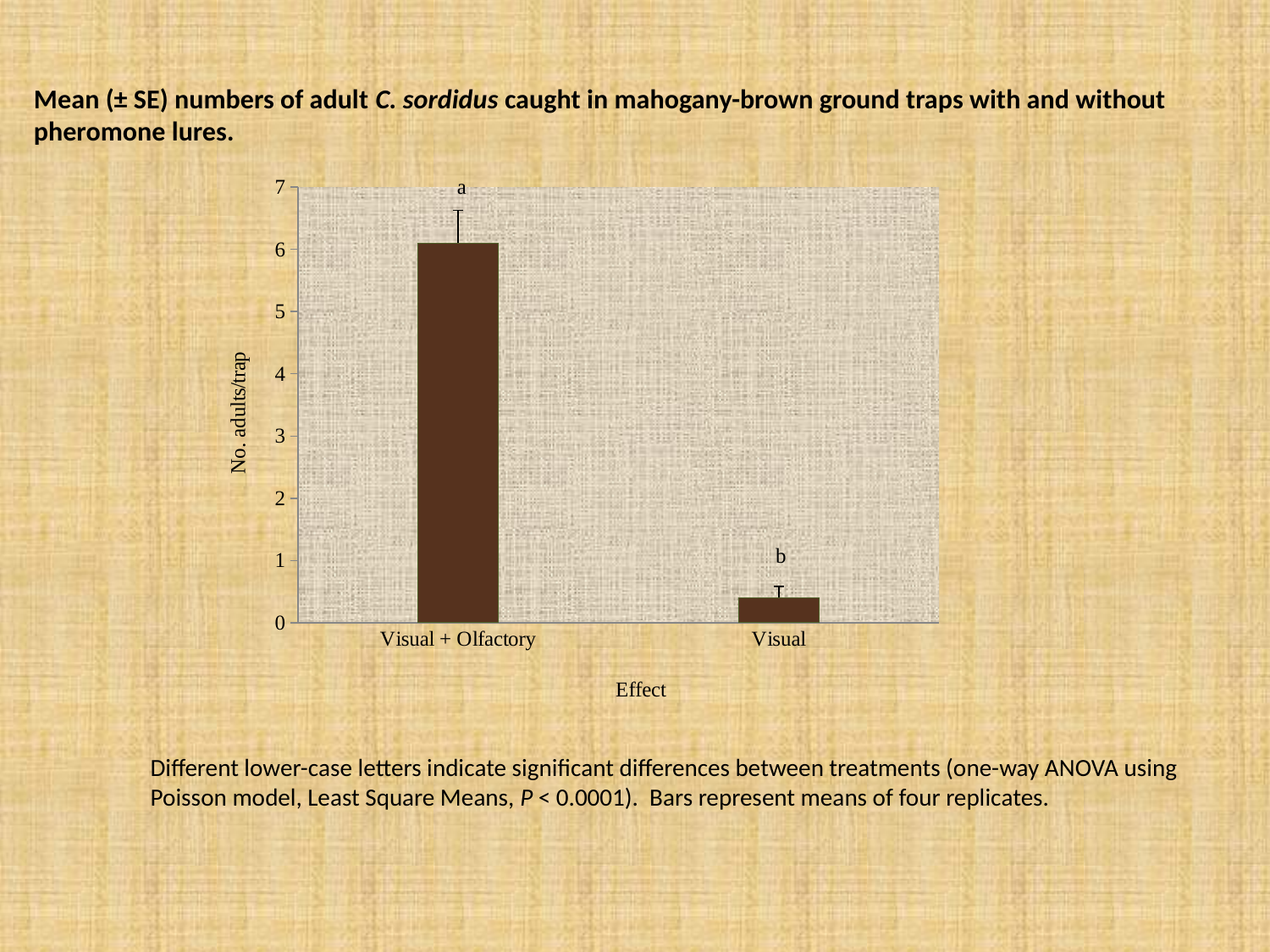
Is the value for Visual + Olfactory greater or less than 5? greater Is the value for Visual greater or less than 1? less What is the title of the y axis of the chart? No. adults/trap Which category has the highest number of adults per trap? Visual + Olfactory What kind of chart is shown on the slide? Bar chart How many categories are plotted on the x axis of the chart? 2 Which is larger, the value for Visual + Olfactory or the value for Visual? Visual + Olfactory Which category has the lowest number of adults per trap? Visual What is the title of the x axis of the chart? Effect Is the value for Visual + Olfactory greater or less than 7? less